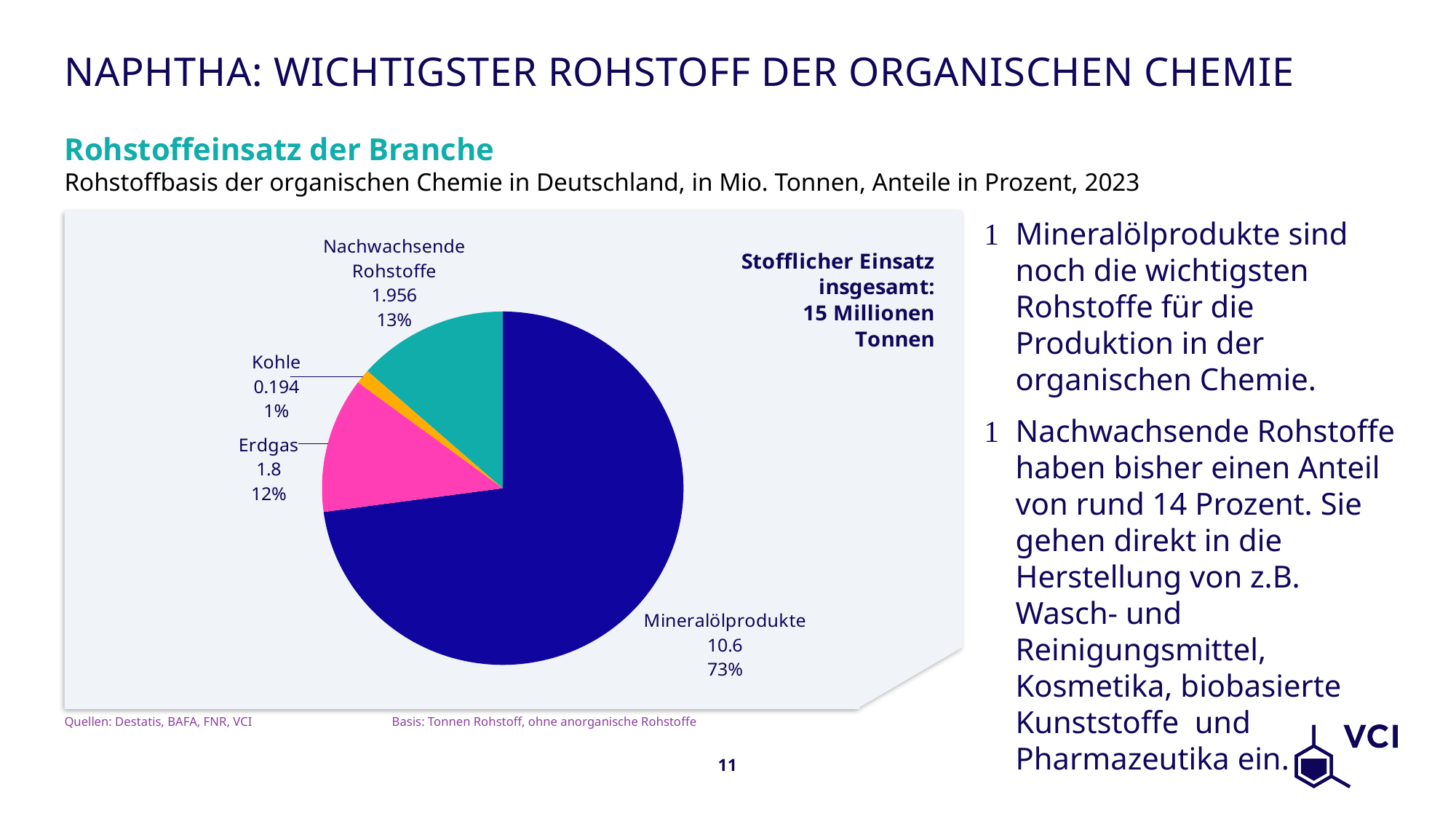
Which is larger, the value for Nachwachsende Rohstoffe or the value for Erdgas? Nachwachsende Rohstoffe What kind of chart is shown on the slide? pie chart How many slices does the pie chart have? 4 What percentage share is shown for Erdgas? 12% What is the difference between the values for Erdgas and Kohle? 1.606 Which category has the smallest slice of the pie? Kohle What is the title of the chart? Rohstoffeinsatz der Branche What percentage share is shown for Mineralölprodukte? 73% What is the value shown for Nachwachsende Rohstoffe? 1.956 Which category has the largest slice of the pie? Mineralölprodukte What is the value shown for Kohle? 0.194 What is the value shown for Mineralölprodukte? 10.6